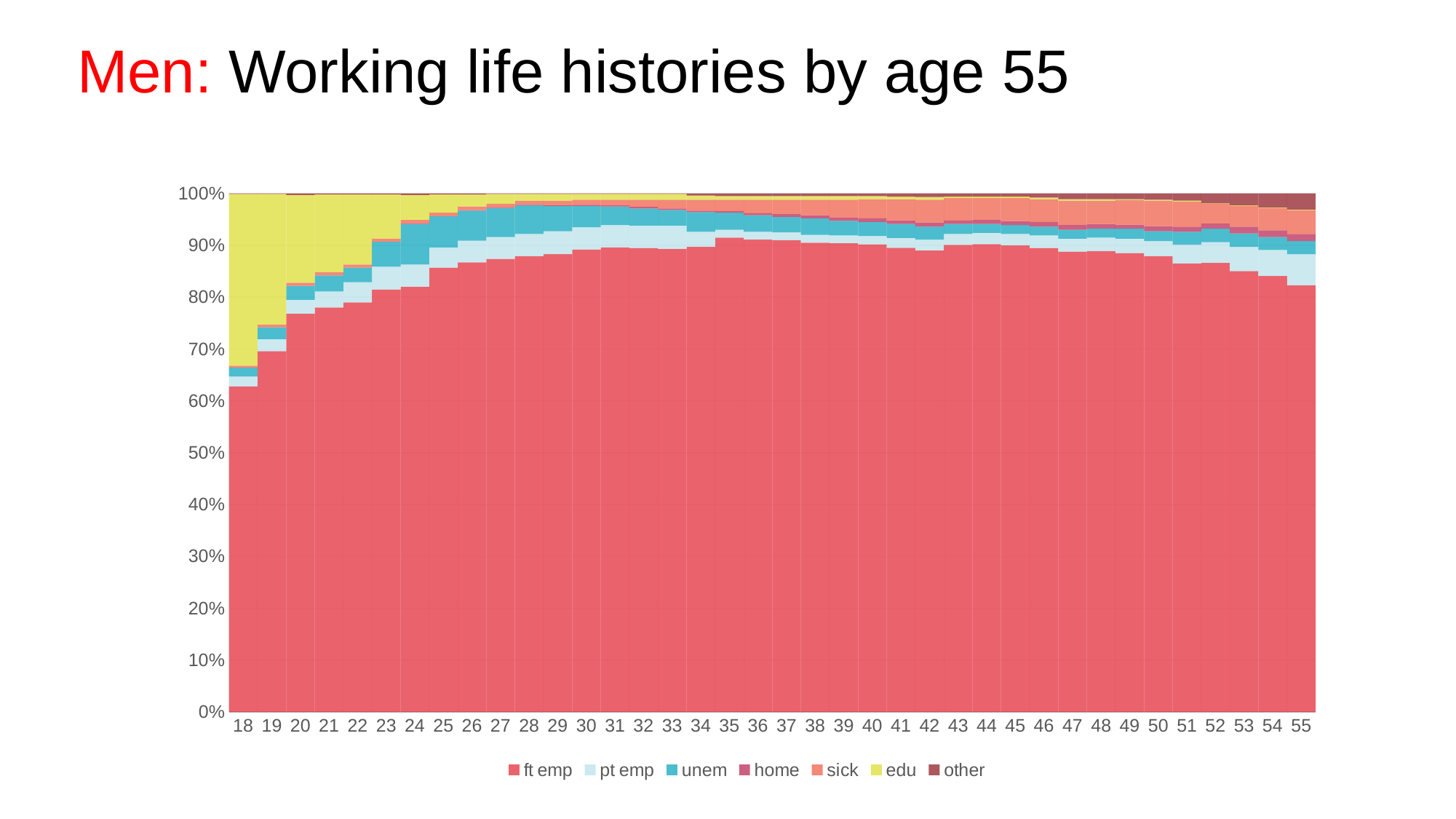
How many age categories are shown along the x axis? 38 How many series does the legend list? 7 What kind of chart is shown on the slide? stacked bar chart Is the edu share at age 18 greater or less than 20%? greater Is the ft emp share at age 18 greater or less than 70%? less Which is larger, the ft emp share at age 18 or at age 55? age 55 Does the ft emp share rise or fall from age 45 to age 55? fall What is the title of the slide? Men: Working life histories by age 55 Which series is shown in yellow in the legend? edu Does the ft emp share rise or fall from age 18 to age 30? rise At which age is the ft emp share lowest? 18 Is the ft emp share at age 55 greater or less than 80%? greater